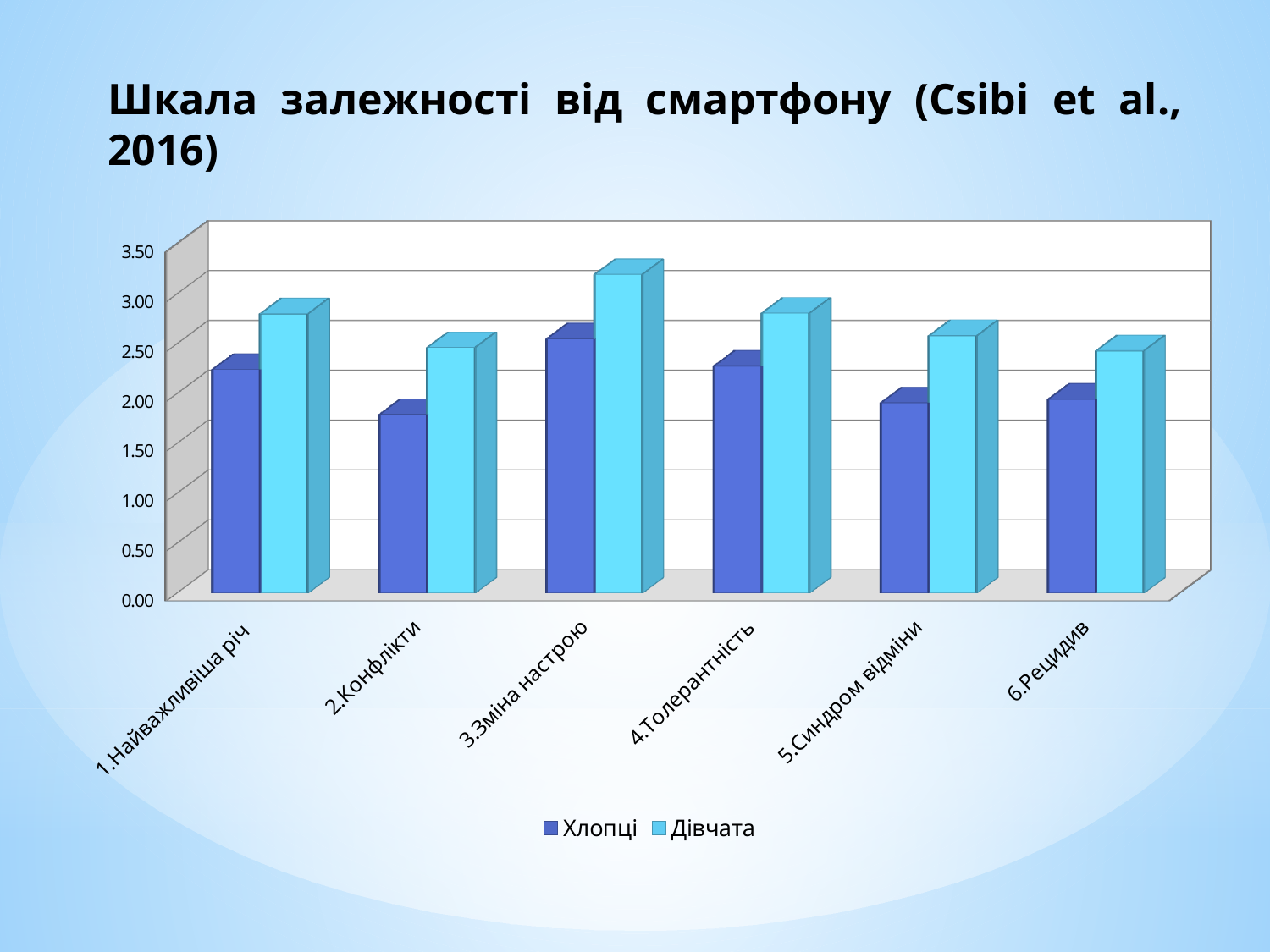
Is the value for Дівчата in 3.Зміна настрою greater or less than 3.00? greater Is the value for Хлопці in 2.Конфлікти greater or less than 2.00? less Which category has the highest value for Хлопці? 3.Зміна настрою Which category has the lowest value for Хлопці? 2.Конфлікти Is the value for Дівчата in 1.Найважливіша річ greater or less than 2.50? greater How many series does the legend list? 2 How many categories are shown on the x axis? 6 For 4.Толерантність, which series has the larger value, Хлопці or Дівчата? Дівчата Which category has the highest value for Дівчата? 3.Зміна настрою What are the two series named in the legend? Хлопці and Дівчата What kind of chart is shown on the slide? bar chart